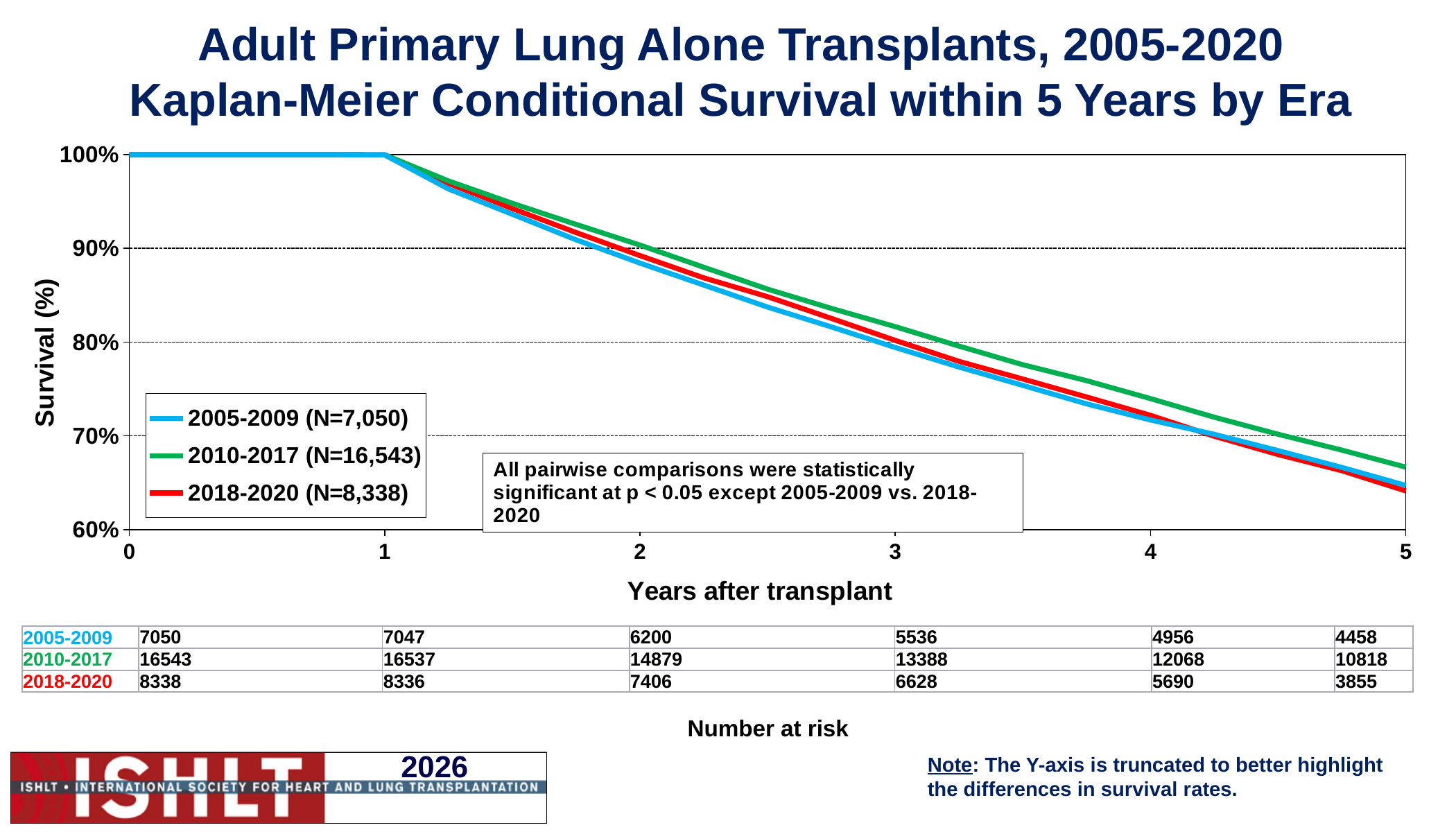
What is the difference between the number at risk for 2010-2017 at year 0 and at year 5? 5725 What colour is the line for the 2018-2020 era? red Is the survival for 2010-2017 at 4 years after transplant greater or less than 70%? greater What kind of chart is shown on the slide? line chart According to the number at risk table, how many 2010-2017 patients were at risk at 2 years? 14879 Which era has the highest survival at 5 years after transplant? 2010-2017 Is the survival for 2010-2017 at 5 years after transplant greater or less than 70%? less According to the number at risk table, how many 2005-2009 patients were at risk at 5 years? 4458 At 3 years after transplant, which is higher: survival for 2010-2017 or for 2005-2009? 2010-2017 Do the survival curves rise or fall as years after transplant increase? fall How many series does the legend list? 3 Is the survival for 2005-2009 at 2 years after transplant greater or less than 90%? less